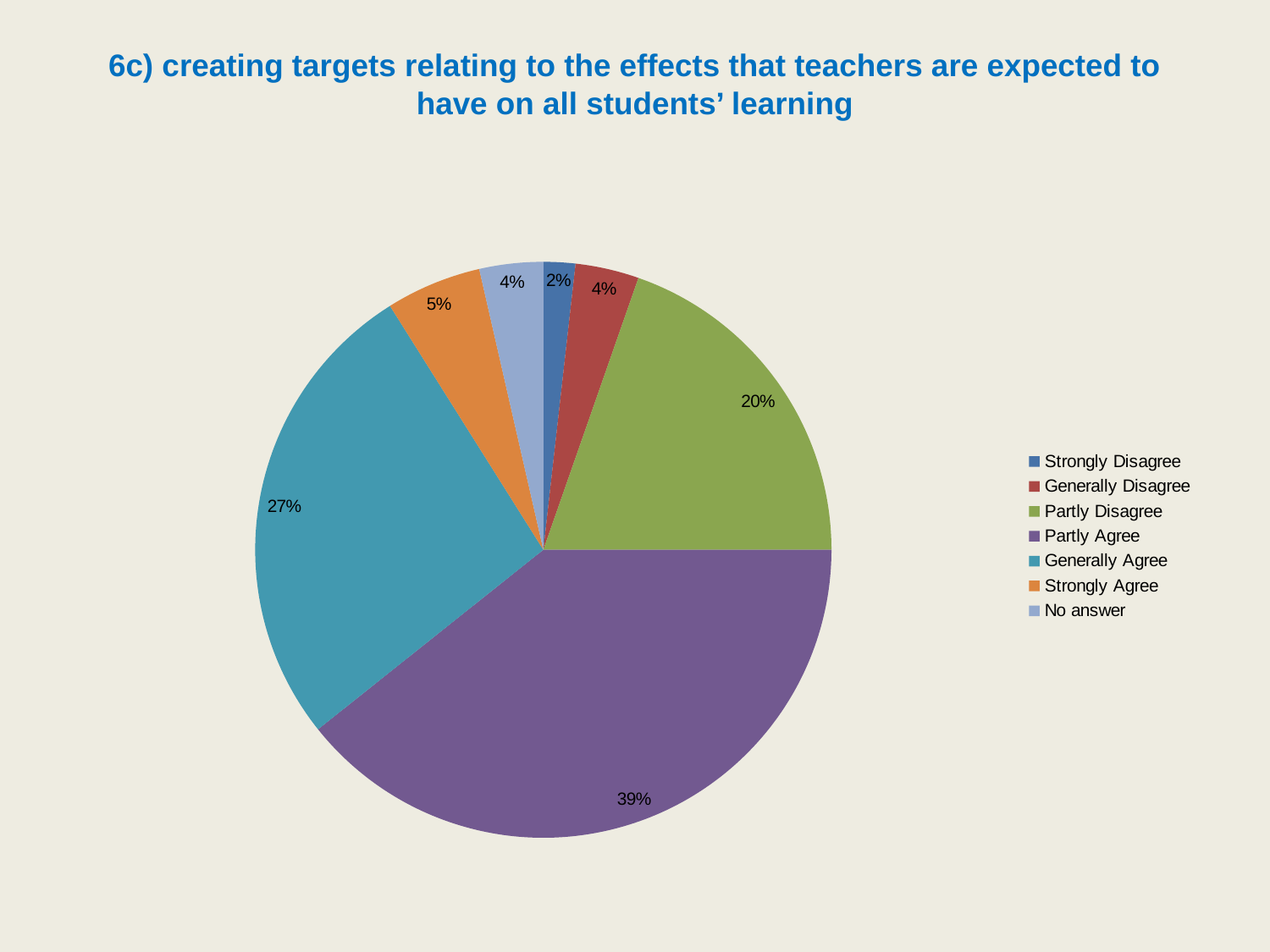
What is the difference in percentage points between Partly Agree and Generally Agree? 12 How many response categories does the legend list? 7 What kind of chart is shown on the slide? pie chart What percentage of respondents chose Generally Agree? 27% What percentage of respondents chose Partly Disagree? 20% What is the title of the chart? 6c) creating targets relating to the effects that teachers are expected to have on all students' learning Which response category has the largest share of the pie? Partly Agree Which response category has the smallest share of the pie? Strongly Disagree What percentage of respondents chose Strongly Agree? 5% What percentage of respondents chose Partly Agree? 39% Which is larger, the share for Partly Disagree or the share for Strongly Agree? Partly Disagree What percentage of respondents chose Strongly Disagree? 2%